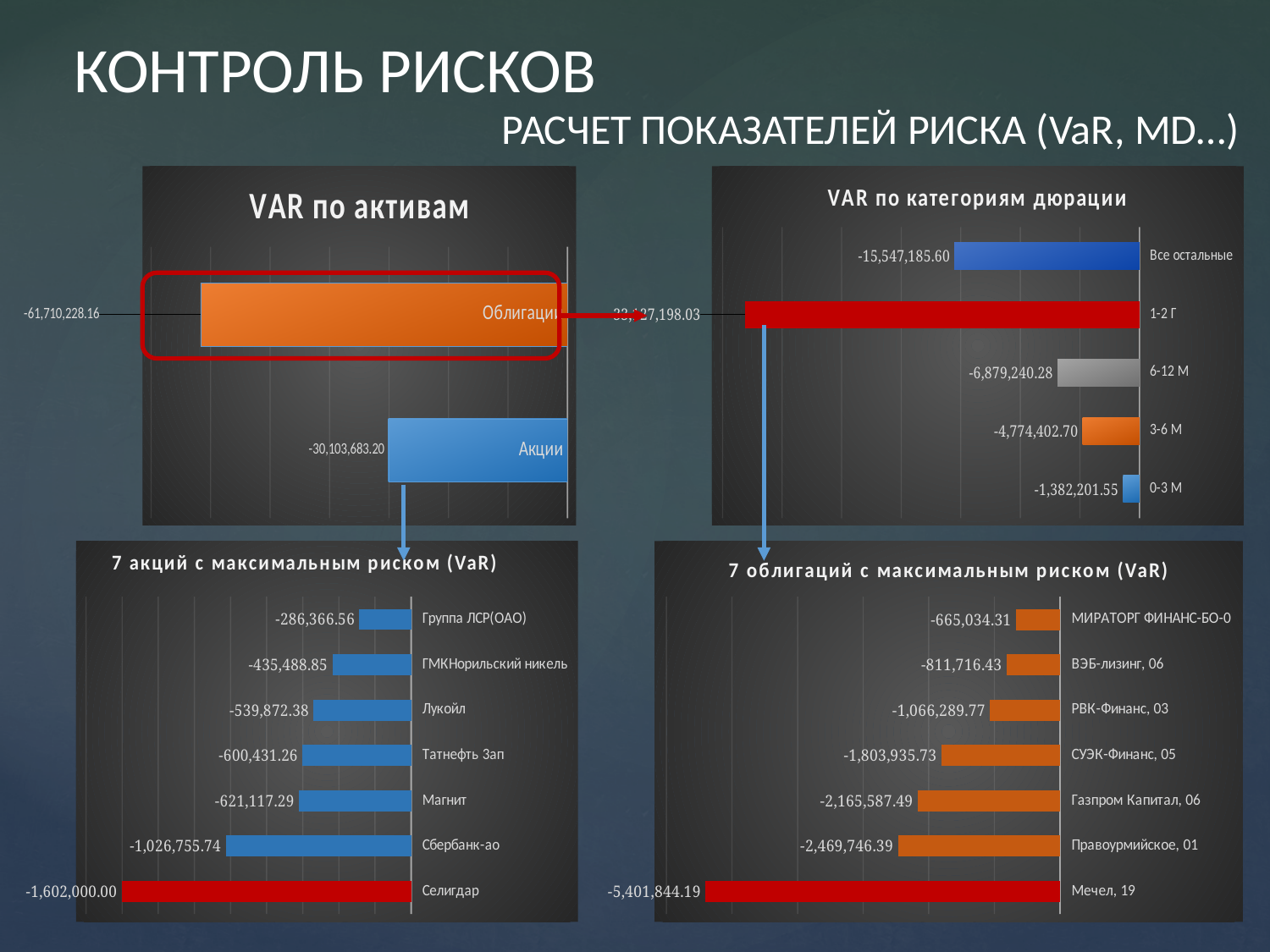
In the 'VAR по категориям дюрации' chart, what is the value for 0-3 М? -1,382,201.55 In the 'VAR по категориям дюрации' chart, what is the value for 6-12 М? -6,879,240.28 In the 'VAR по активам' chart, what is the value for Облигации? -61,710,228.16 In the '7 акций с максимальным риском (VaR)' chart, what is the value for Селигдар? -1,602,000.00 In the 'VAR по активам' chart, what is the difference in magnitude between the Облигации and Акции values? 31,606,544.96 What type of chart is the '7 облигаций с максимальным риском (VaR)' chart? Bar chart In the '7 облигаций с максимальным риском (VaR)' chart, what is the value for Мечел, 19? -5,401,844.19 In the '7 акций с максимальным риском (VaR)' chart, what is the difference in magnitude between Селигдар and Сбербанк-ао? 575,244.26 In the 'VAR по активам' chart, what is the value for Акции? -30,103,683.20 In the 'VAR по категориям дюрации' chart, which category has the longest bar? 1-2 Г In the '7 облигаций с максимальным риском (VaR)' chart, which bond has the shortest bar? МИРАТОРГ ФИНАНС-БО-0 In the 'VAR по категориям дюрации' chart, how many duration categories are shown? 5